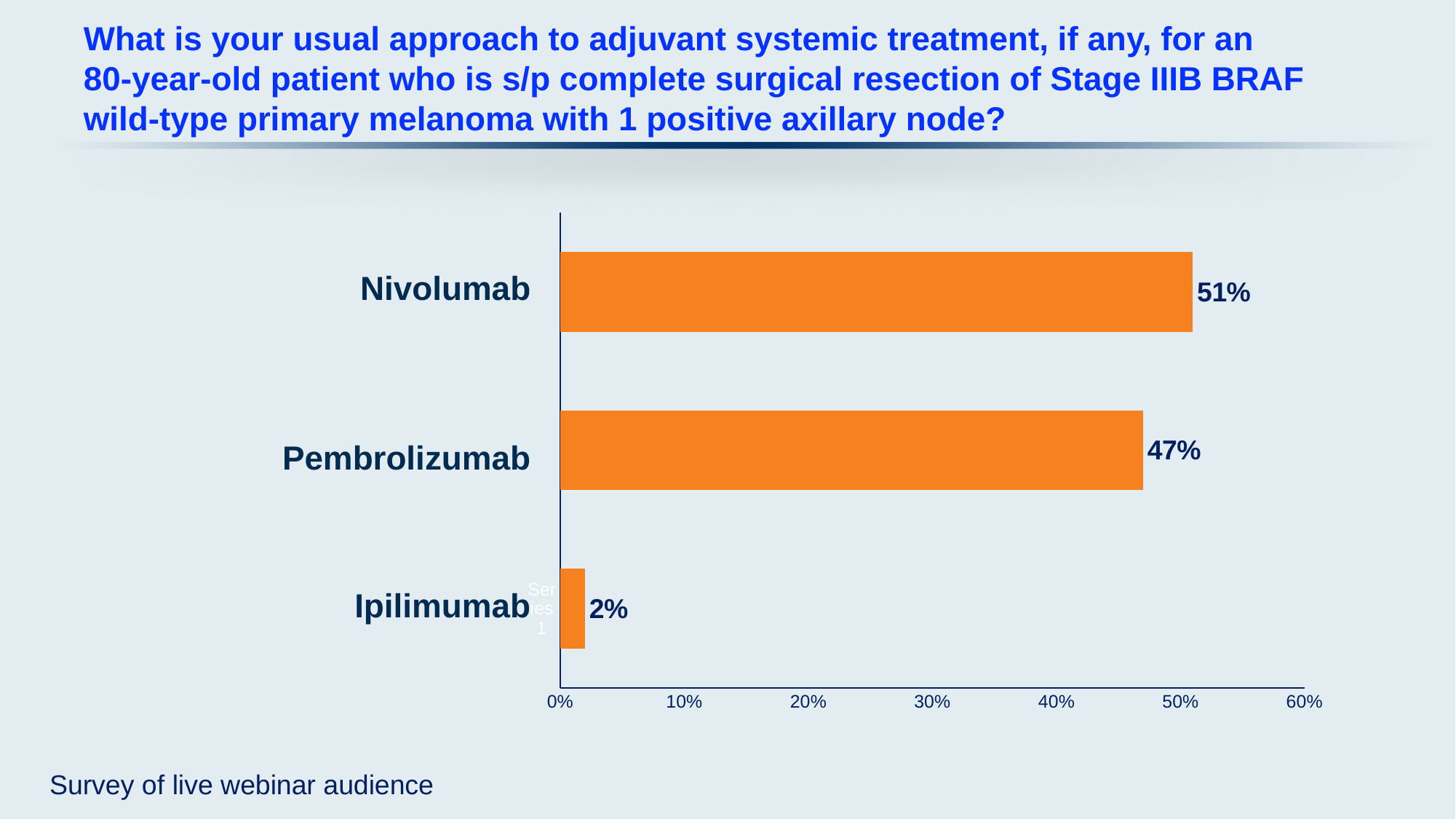
What percentage of respondents chose Pembrolizumab? 47% What is the difference in percentage points between Nivolumab and Pembrolizumab? 4% How many treatment options are shown in the chart? 3 Which treatment option received the highest share of responses? Nivolumab What percentage of respondents chose Nivolumab? 51% What is the difference in percentage points between Pembrolizumab and Ipilimumab? 45% Which received a larger share of responses, Nivolumab or Pembrolizumab? Nivolumab What percentage of respondents chose Ipilimumab? 2% What kind of chart is shown on the slide? Bar chart Which treatment option received the lowest share of responses? Ipilimumab Is the value for Pembrolizumab greater or less than 40%? greater What is the maximum value shown on the horizontal axis? 60%